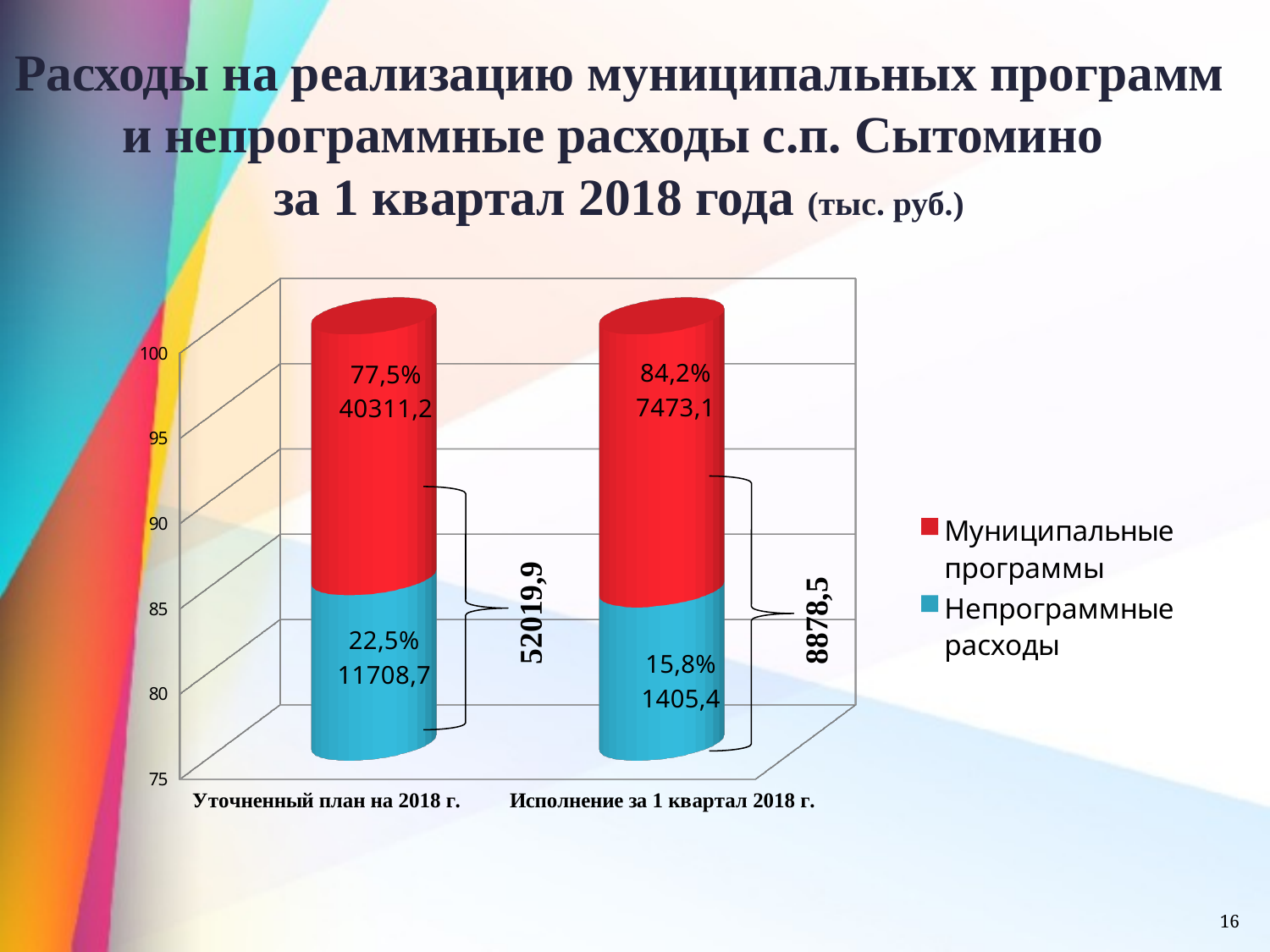
Which colour represents Непрограммные расходы in the chart? blue What is the value for Муниципальные программы in the category Исполнение за 1 квартал 2018 г.? 7473,1 What is the value for Непрограммные расходы in the category Исполнение за 1 квартал 2018 г.? 1405,4 What is the total of the stacked bar for Уточненный план на 2018 г.? 52019,9 How many series does the legend list? 2 What is the total of the stacked bar for Исполнение за 1 квартал 2018 г.? 8878,5 How many categories are shown on the x axis? 2 What type of chart is shown on the slide? bar chart What is the value for Непрограммные расходы in the category Уточненный план на 2018 г.? 11708,7 What percentage share do Муниципальные программы make up in the category Уточненный план на 2018 г.? 77,5% What is the value for Муниципальные программы in the category Уточненный план на 2018 г.? 40311,2 What percentage share do Непрограммные расходы make up in the category Исполнение за 1 квартал 2018 г.? 15,8%